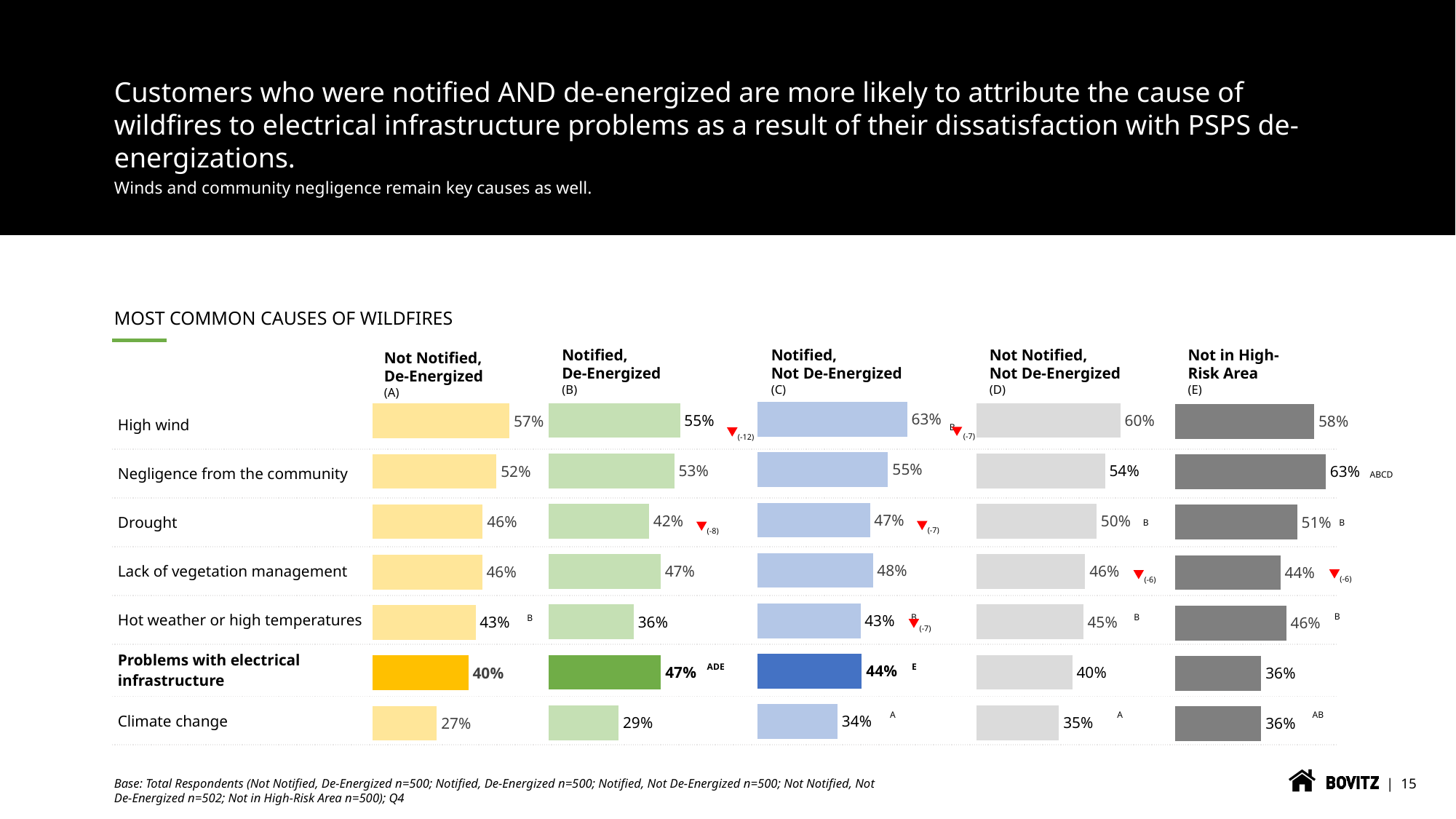
How many causes of wildfires are listed in the charts? 7 What is the title of the chart section on the slide? MOST COMMON CAUSES OF WILDFIRES For Hot weather or high temperatures, which is larger: the 'Notified, De-Energized' value or the 'Not Notified, Not De-Energized' value? Not Notified, Not De-Energized What kind of chart is used to show the most common causes of wildfires? Bar chart In the 'Notified, De-Energized' chart, which cause has the lowest value? Climate change In the 'Not Notified, De-Energized' chart, which cause has the highest value? High wind In the 'Notified, De-Energized' chart, what is the value for Problems with electrical infrastructure? 47% In the 'Not in High-Risk Area' chart, what is the value for Negligence from the community? 63% In the 'Notified, Not De-Energized' chart, what is the value for Climate change? 34% In the 'Not Notified, Not De-Energized' chart, what is the difference between Drought and Problems with electrical infrastructure? 10% In the 'Notified, Not De-Energized' chart, what is the difference between High wind and Climate change? 29%